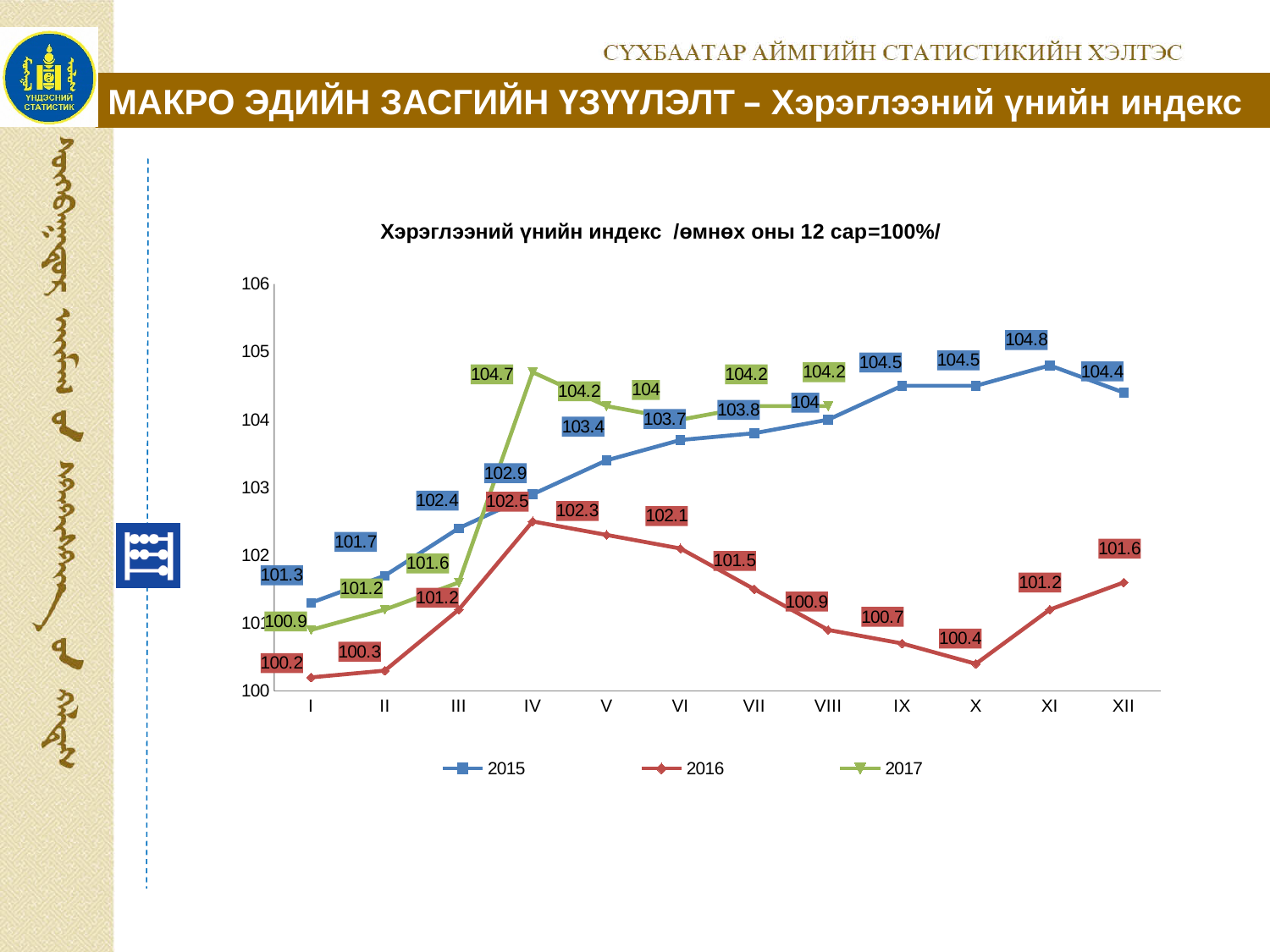
What is the value for 2017 in month IV? 104.7 In month IV, which is larger: the 2015 value or the 2016 value? 2015 Is the value for 2015 in month I greater or less than 102? less In which month does the 2015 series reach its highest value? XI What is the value for 2016 in month X? 100.4 What kind of chart is shown on the slide? line chart How many series does the legend list? 3 How many months are shown along the x axis? 12 Does the 2016 series rise or fall from month IV to month X? fall What is the value for 2015 in month XI? 104.8 What is the difference between the 2015 and 2016 values in month XII? 2.8 In which month does the 2016 series have its lowest value? I